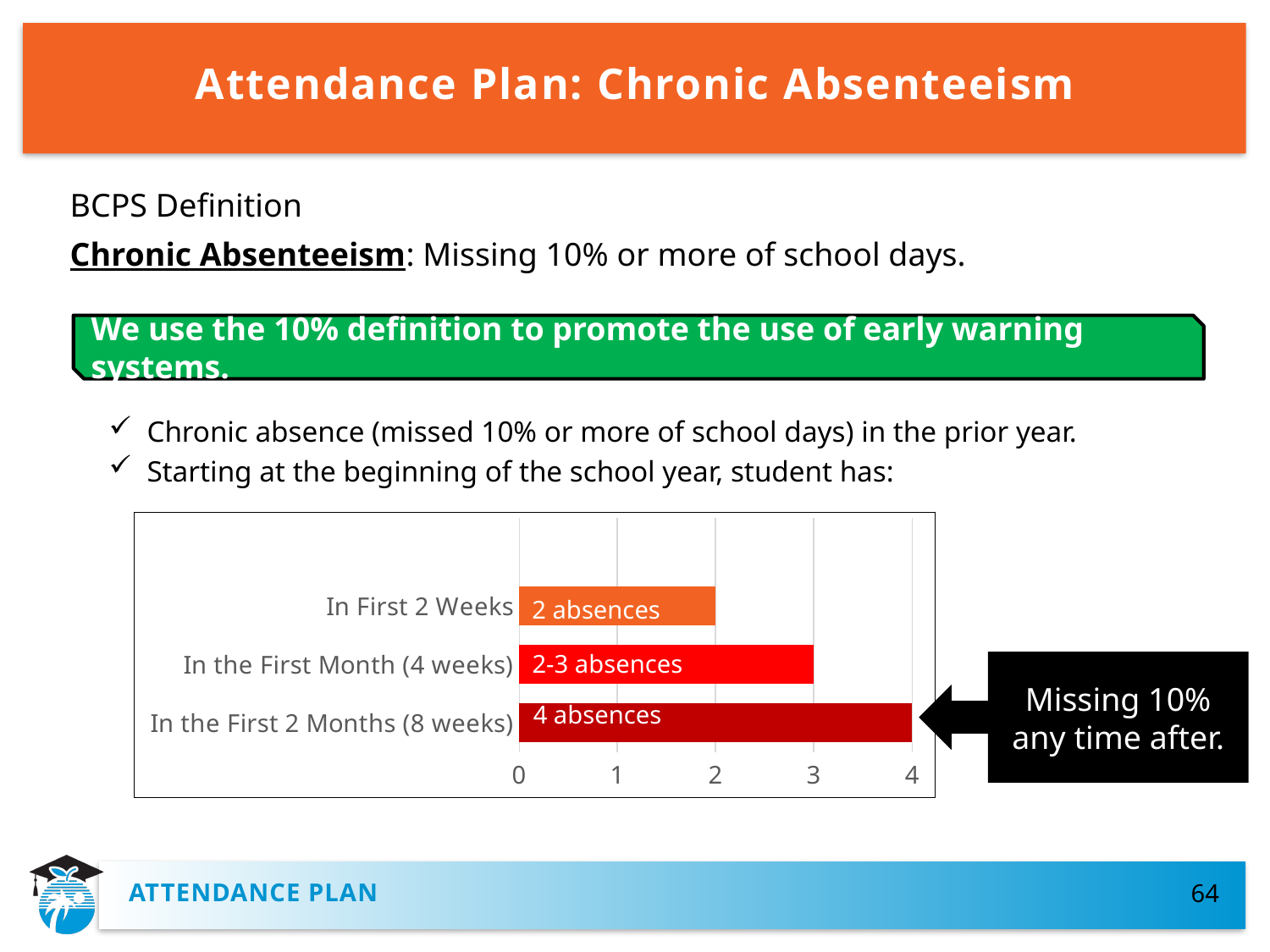
What is the highest value shown on the horizontal axis? 4 What kind of chart is shown on the slide? bar chart Is the bar for "In the First 2 Months (8 weeks)" greater or less than 3 on the axis? greater Which category has the longest bar? In the First 2 Months (8 weeks) What is the data label on the bar for "In the First Month (4 weeks)"? 2-3 absences What is the data label on the bar for "In First 2 Weeks"? 2 absences At which axis value does the bar for "In the First Month (4 weeks)" end? 3 Which bar is longer: "In First 2 Weeks" or "In the First Month (4 weeks)"? In the First Month (4 weeks) What colour is the bar for "In First 2 Weeks"? orange How many categories does the chart show? 3 What is the data label on the bar for "In the First 2 Months (8 weeks)"? 4 absences Which category has the shortest bar? In First 2 Weeks